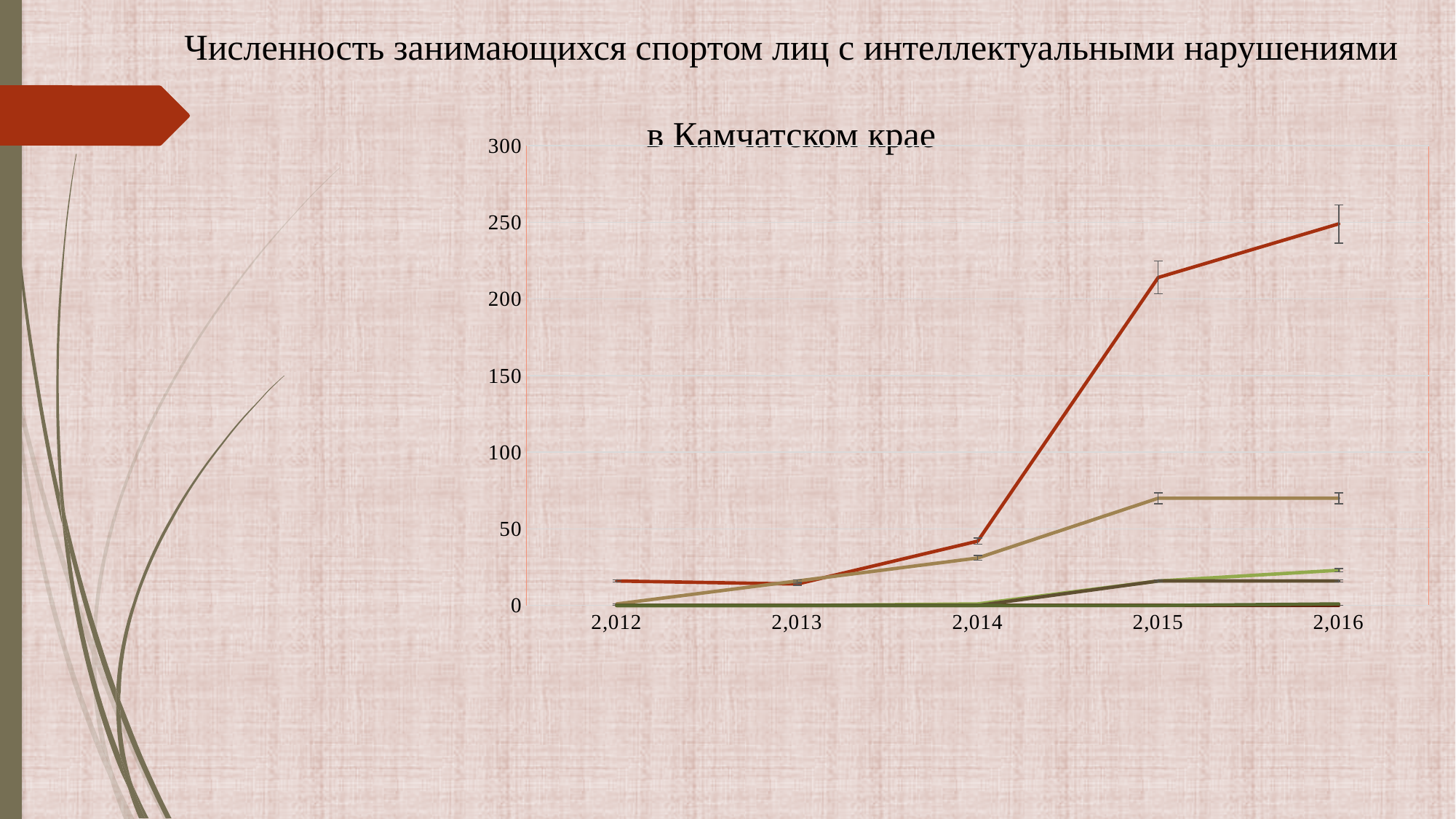
Is the value of the red line at 2,015 greater or less than 200? greater In which year does the red line reach its highest value? 2,016 What kind of chart is shown on the slide? line chart Does the red line rise or fall between 2,014 and 2,016? rise How many years are shown along the x axis of the chart? 5 What is the highest value shown on the y axis of the chart? 300 What is the last year shown on the x axis of the chart? 2,016 Is the value of the red line at 2,014 greater or less than 100? less What is the first year shown on the x axis of the chart? 2,012 Is the value of the tan (light brown) line at 2,015 greater or less than 50? greater